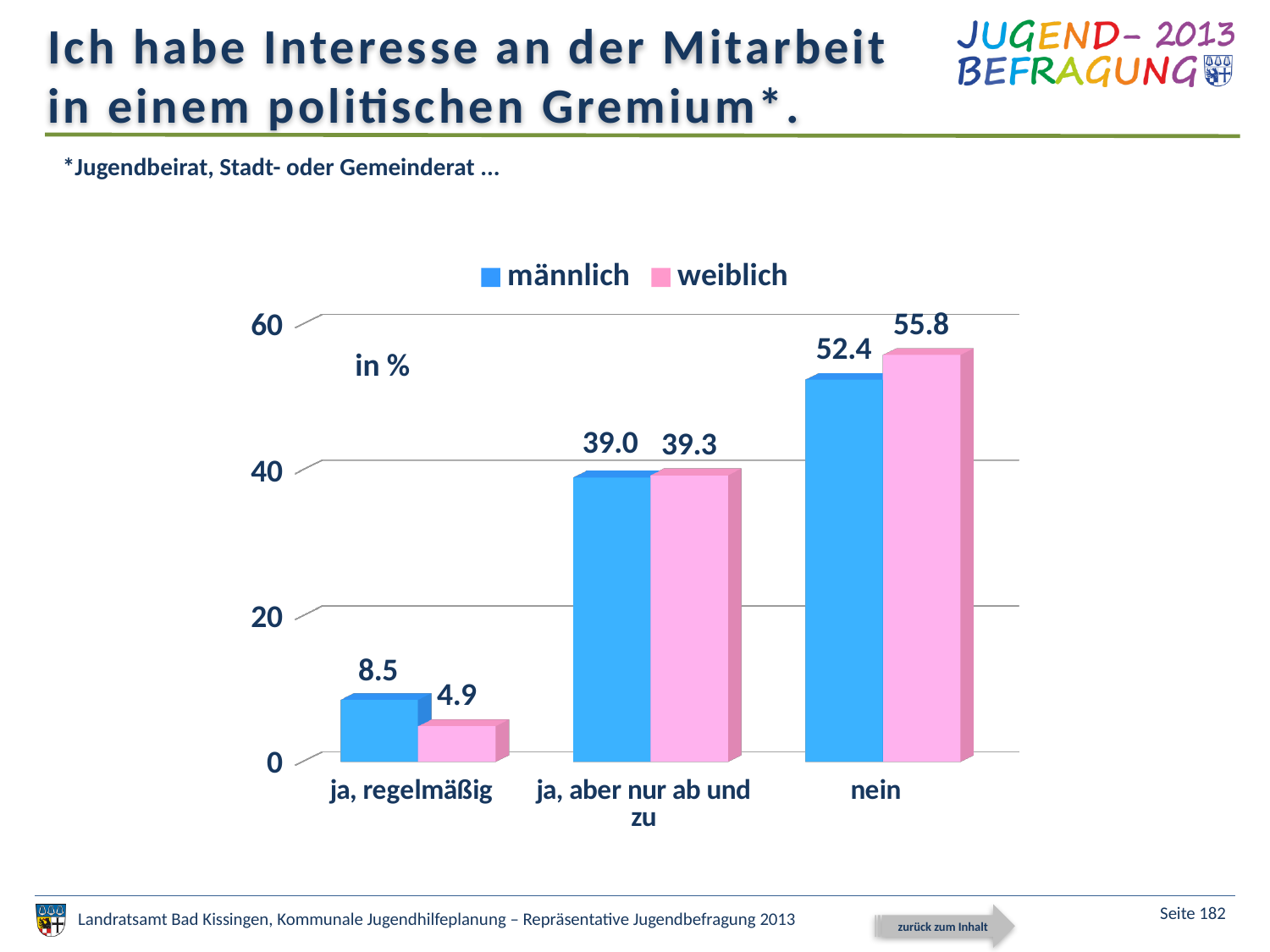
What is the difference between the weiblich and männlich values in the category "nein"? 3.4 What kind of chart is shown on the slide? bar chart How many series does the legend list? 2 What is the value for männlich in the category "ja, regelmäßig"? 8.5 What is the value for weiblich in the category "ja, aber nur ab und zu"? 39.3 Which category has the lowest value for weiblich? ja, regelmäßig In the category "ja, regelmäßig", which series has the larger value, männlich or weiblich? männlich What is the value for weiblich in the category "nein"? 55.8 How many categories are shown on the x axis? 3 Which colour represents the series weiblich in the legend? pink Which category has the highest value for männlich? nein Is the value for männlich in the category "nein" greater or less than 40? greater